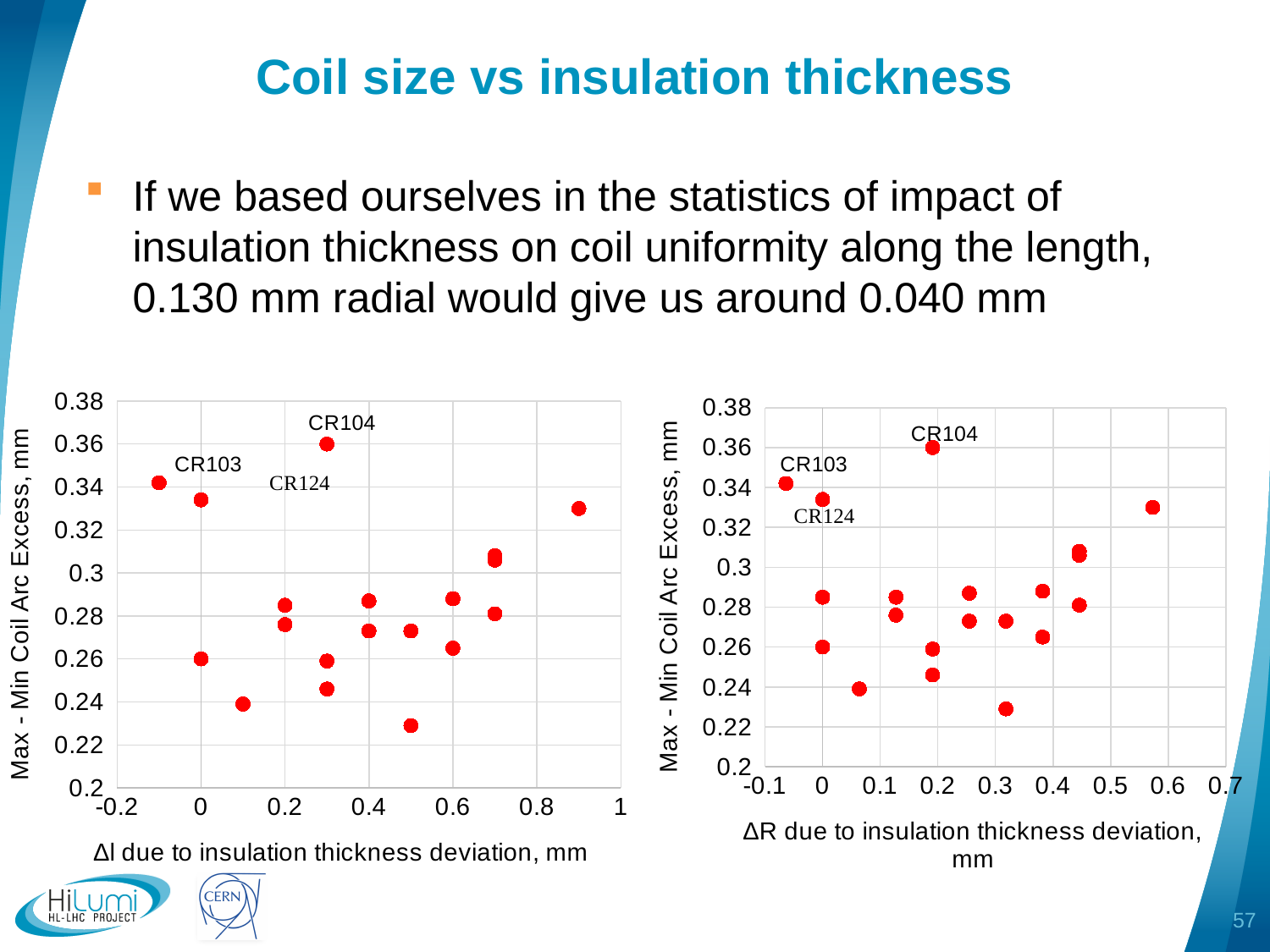
In the right chart, which labelled point has the highest Max - Min Coil Arc Excess? CR104 In the left chart, which labelled point has the highest Max - Min Coil Arc Excess? CR104 In the right chart, which has the higher Max - Min Coil Arc Excess, CR103 or CR124? CR103 In the left chart, is the lowest plotted point greater or less than 0.24 on the y axis? less In the right chart, is the Max - Min Coil Arc Excess for CR124 greater or less than 0.3? greater In the right chart, is the Max - Min Coil Arc Excess for CR103 greater or less than 0.32? greater What kind of chart is the left chart on the slide? scatter chart In the left chart, which has the higher Max - Min Coil Arc Excess, CR103 or CR104? CR104 What is the y-axis title of the left chart? Max - Min Coil Arc Excess, mm What is the x-axis title of the right chart? ΔR due to insulation thickness deviation, mm What kind of chart is the right chart on the slide? scatter chart